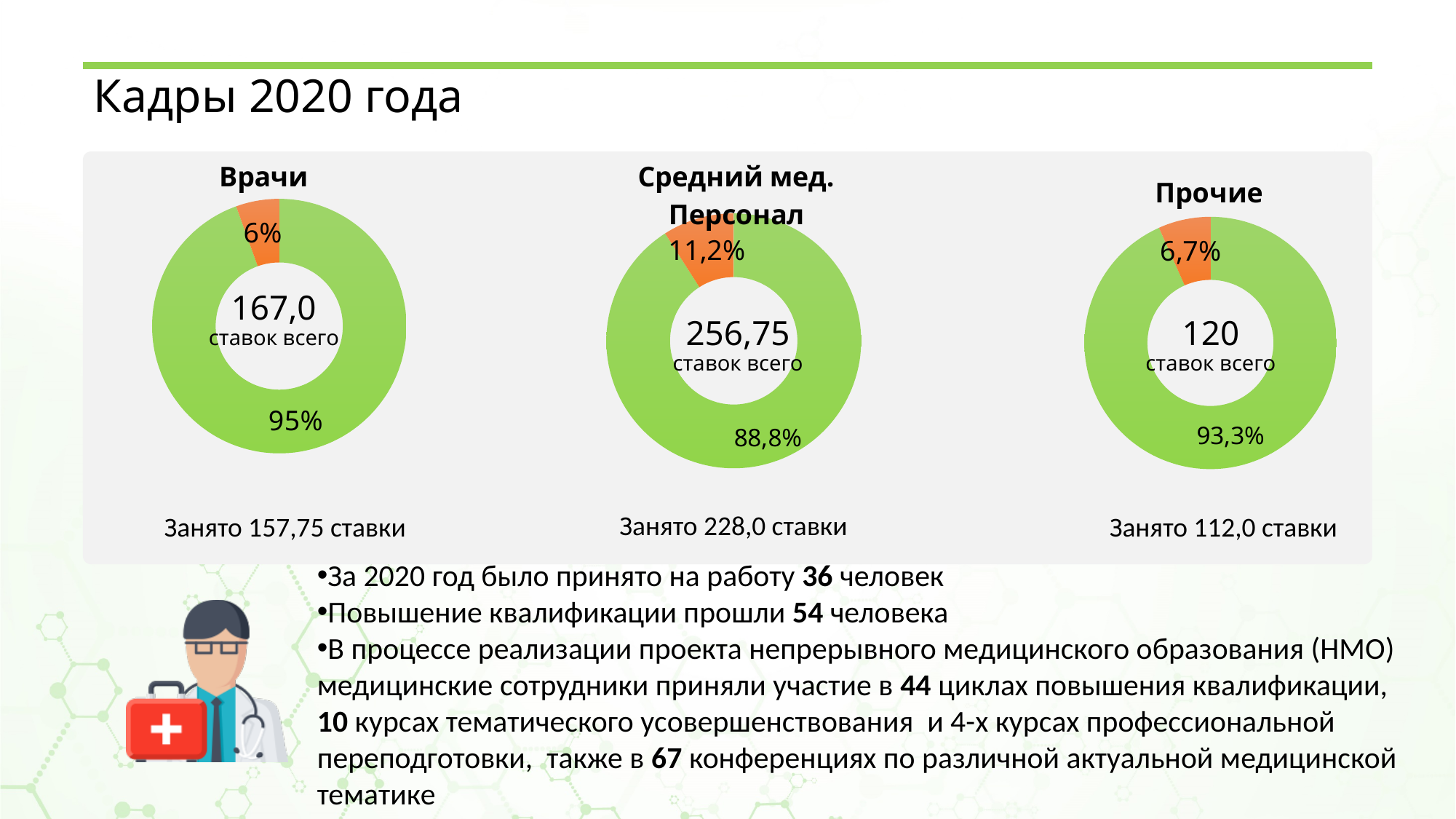
In the "Прочие" chart, what percentage is shown for the green slice? 93,3% What total number of positions (ставок всего) is shown in the centre of the "Прочие" chart? 120 In the "Врачи" chart, what percentage is shown for the green (larger) slice? 95% In the "Врачи" chart, what percentage is shown for the orange (smaller) slice? 6% Which of the three donut charts has the largest orange slice? Средний мед. персонал Is the orange slice in the "Прочие" chart larger or smaller than the orange slice in the "Средний мед. персонал" chart? Smaller How many donut charts are shown on the slide? 3 What total number of positions (ставок всего) is shown in the centre of the "Средний мед. персонал" chart? 256,75 In the "Средний мед. персонал" chart, what percentage is shown for the orange slice? 11,2% In the "Прочие" chart, what percentage is shown for the orange slice? 6,7% In the "Средний мед. персонал" chart, what percentage is shown for the green slice? 88,8% What type of chart is used for the "Врачи" chart? Donut (pie) chart